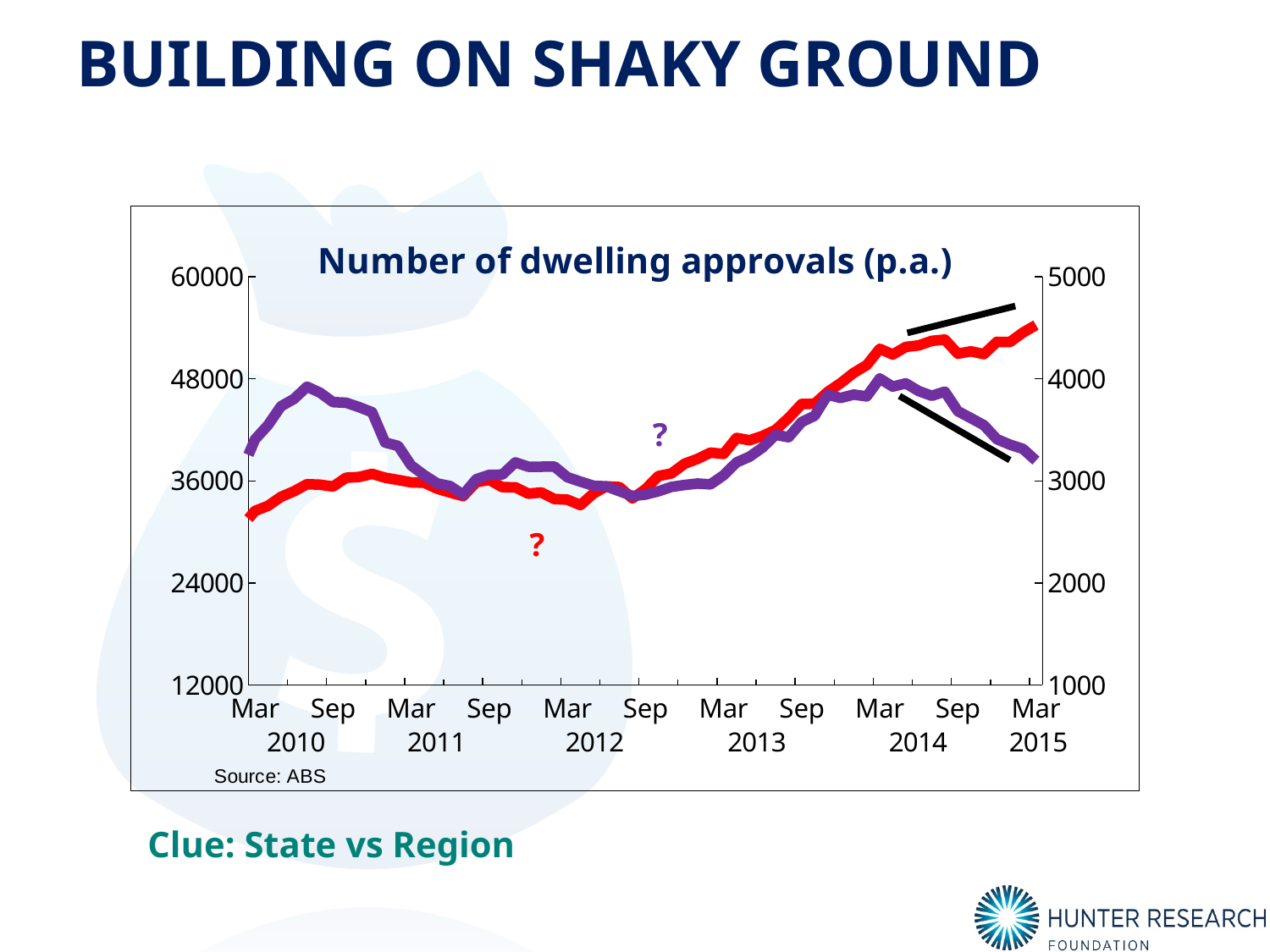
At Mar 2015, is the red line above or below the 48000 gridline on the left axis? Above What is the lowest value shown on the right vertical axis? 1000 What is the highest value shown on the left vertical axis? 60000 At Mar 2010, is the red line above or below the 36000 gridline on the left axis? Below Does the purple line rise or fall between Mar 2014 and Mar 2015? Falls Which year is the last one labelled on the horizontal axis? 2015 What is the title of the chart? Number of dwelling approvals (p.a.) Does the red line rise or fall between Mar 2013 and Mar 2015? Rises At Mar 2015, which line is higher on the chart, the red line or the purple line? The red line How many lines are plotted on the chart? 2 What kind of chart is shown on the slide? Line chart What source is cited below the chart? ABS